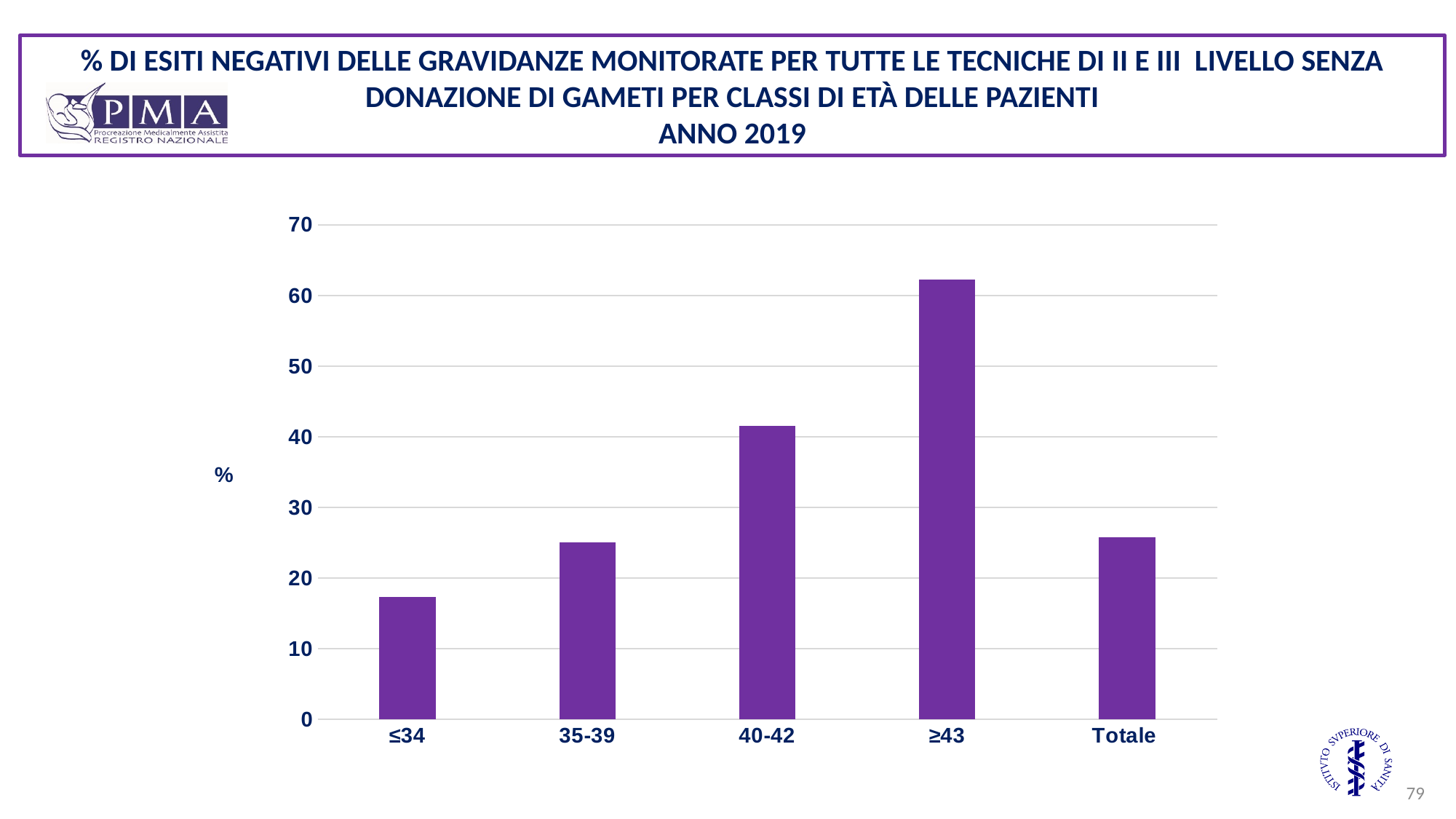
What kind of chart is shown on the slide? bar chart Which is larger, the value for 40-42 or the value for 35-39? 40-42 Which age class has the highest percentage of negative outcomes? ≥43 Is the value for Totale greater or less than 30? less Is the value for ≥43 greater or less than 50? greater What label is shown on the y axis of the chart? % How many categories are shown on the x axis of the chart? 5 Is the value for ≤34 greater or less than 20? less Do the values rise or fall across the age classes from ≤34 to ≥43? rise Which category has the lowest bar in the chart? ≤34